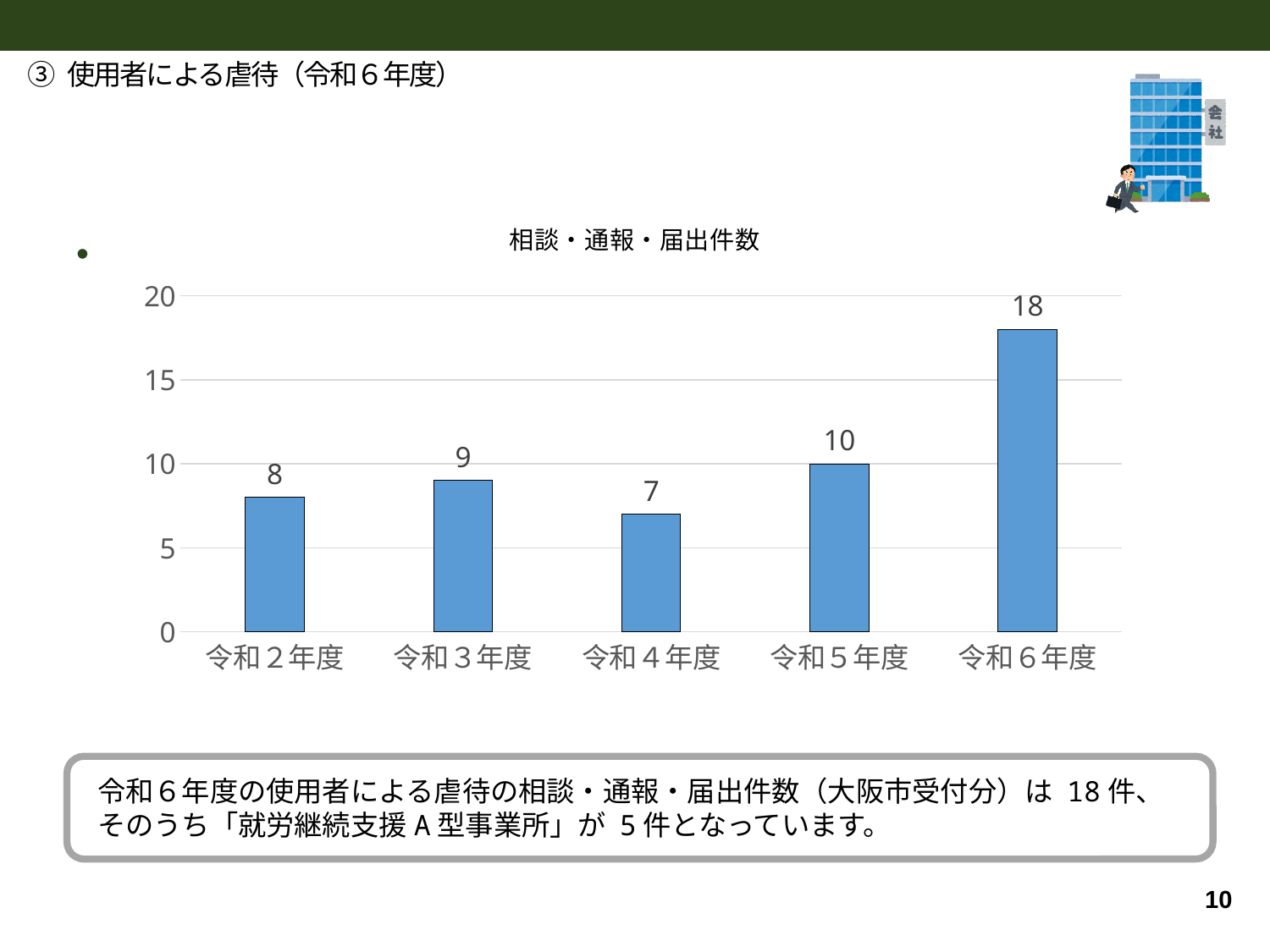
What kind of chart is shown? bar chart What is the title of the chart? 相談・通報・届出件数 What is the value for 令和４年度? 7 Which is larger, the value for 令和３年度 or 令和４年度? 令和３年度 What is the value for 令和２年度? 8 Which year has the lowest value? 令和４年度 Is the value for 令和６年度 greater or less than 15? greater What is the value for 令和６年度? 18 Do the values rise or fall from 令和４年度 to 令和６年度? rise What is the difference between the values for 令和６年度 and 令和５年度? 8 How many years are shown on the x axis? 5 Which year has the highest value? 令和６年度